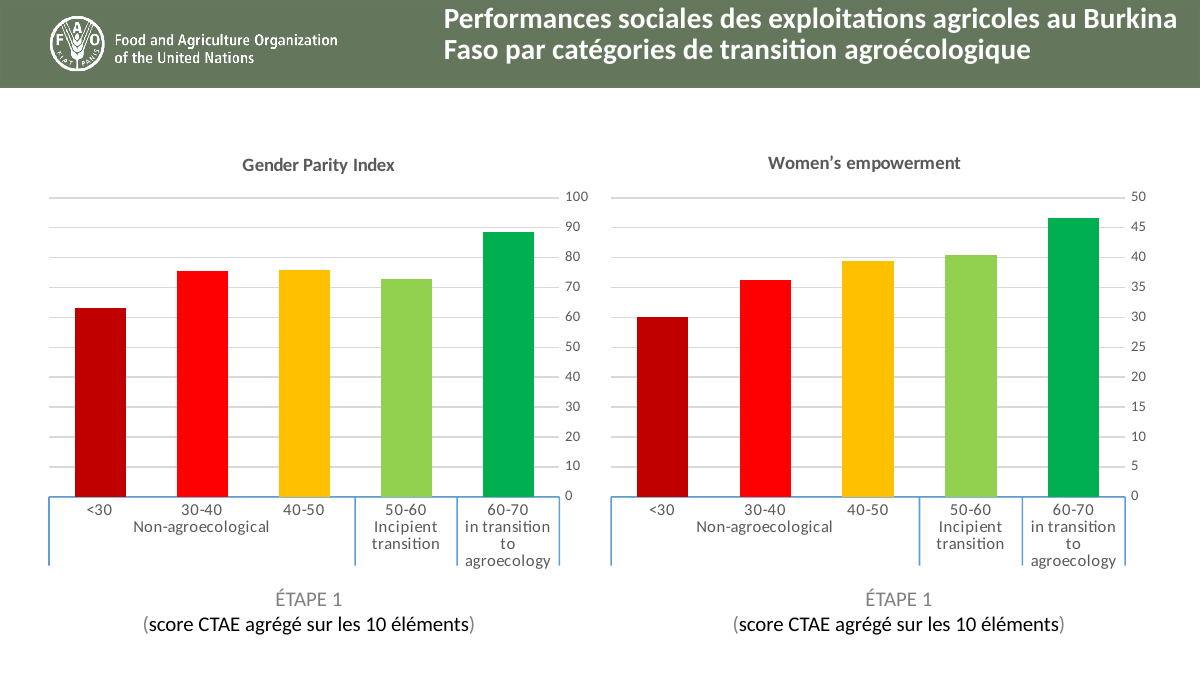
In the Gender Parity Index chart, is the value for 60-70 greater or less than 80? greater How many categories are shown in the Women's empowerment chart? 5 In the Gender Parity Index chart, which category has the lowest value? <30 What is the title of the chart on the right side of the slide? Women's empowerment In the Women's empowerment chart, which category has the lowest value? <30 In the Women's empowerment chart, is the value for 60-70 greater or less than 40? greater In the Women's empowerment chart, which category has the highest value? 60-70 in transition to agroecology In the Gender Parity Index chart, which is larger, the value for 60-70 or the value for 50-60? 60-70 What kind of chart is the Gender Parity Index chart? bar chart In the Women's empowerment chart, do the values rise or fall from <30 to 60-70? rise In the Gender Parity Index chart, is the value for <30 greater or less than 70? less In the Gender Parity Index chart, which category has the highest value? 60-70 in transition to agroecology